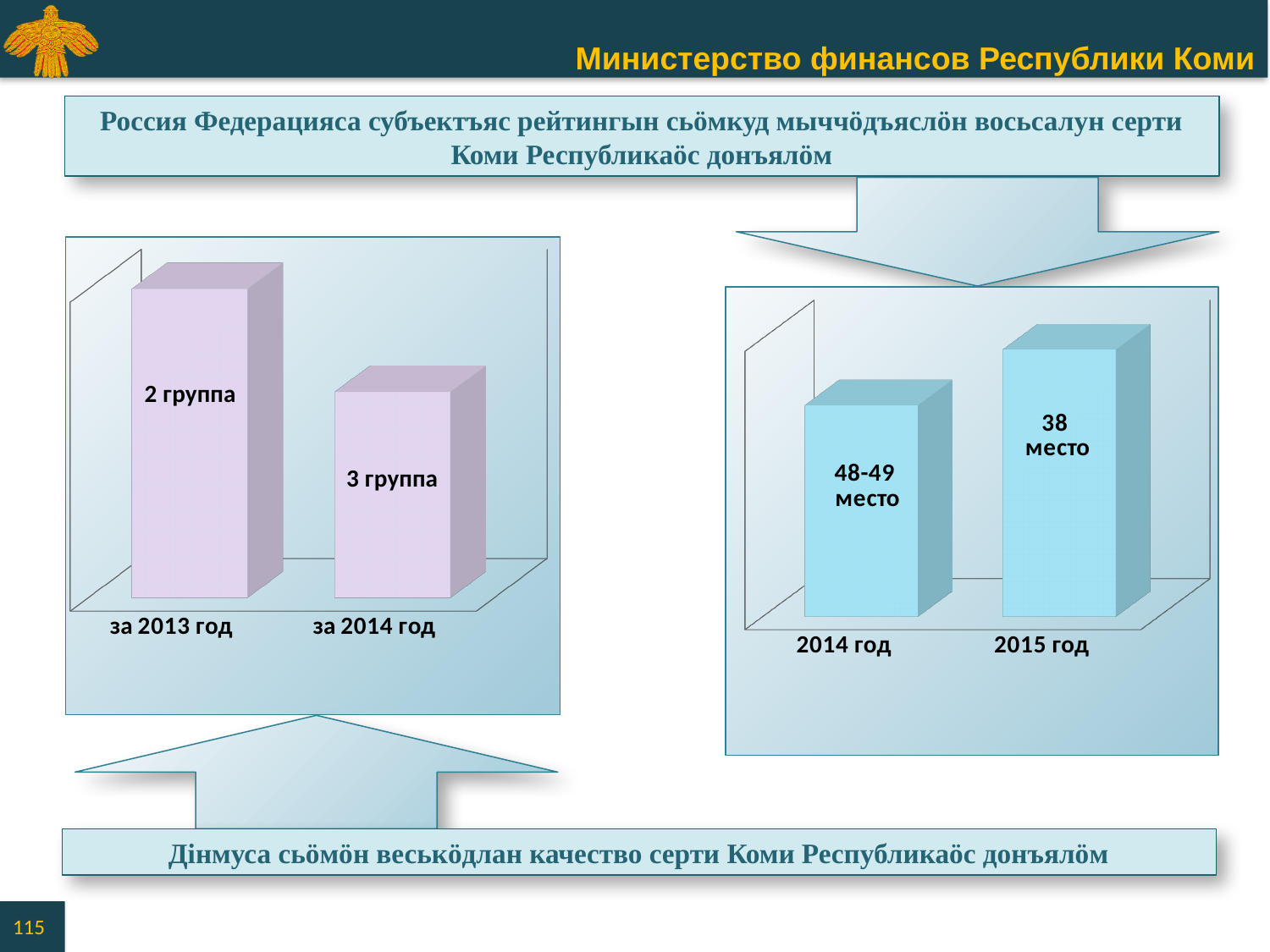
In the right chart, what label is shown on the bar for 2015 год? 38 место How many bars does the left chart show? 2 In the right chart, which bar is taller, 2014 год or 2015 год? 2015 год In the left chart, what label is shown on the bar for за 2013 год? 2 группа In the right chart, what label is shown on the bar for 2014 год? 48-49 место In the left chart, what label is shown on the bar for за 2014 год? 3 группа In the right chart, do the bar heights rise or fall from 2014 год to 2015 год? rise How many bars does the right chart show? 2 What kind of chart is the left chart? bar chart What kind of chart is the right chart? bar chart In the left chart, which bar is taller, за 2013 год or за 2014 год? за 2013 год What are the category labels on the x axis of the right chart? 2014 год, 2015 год